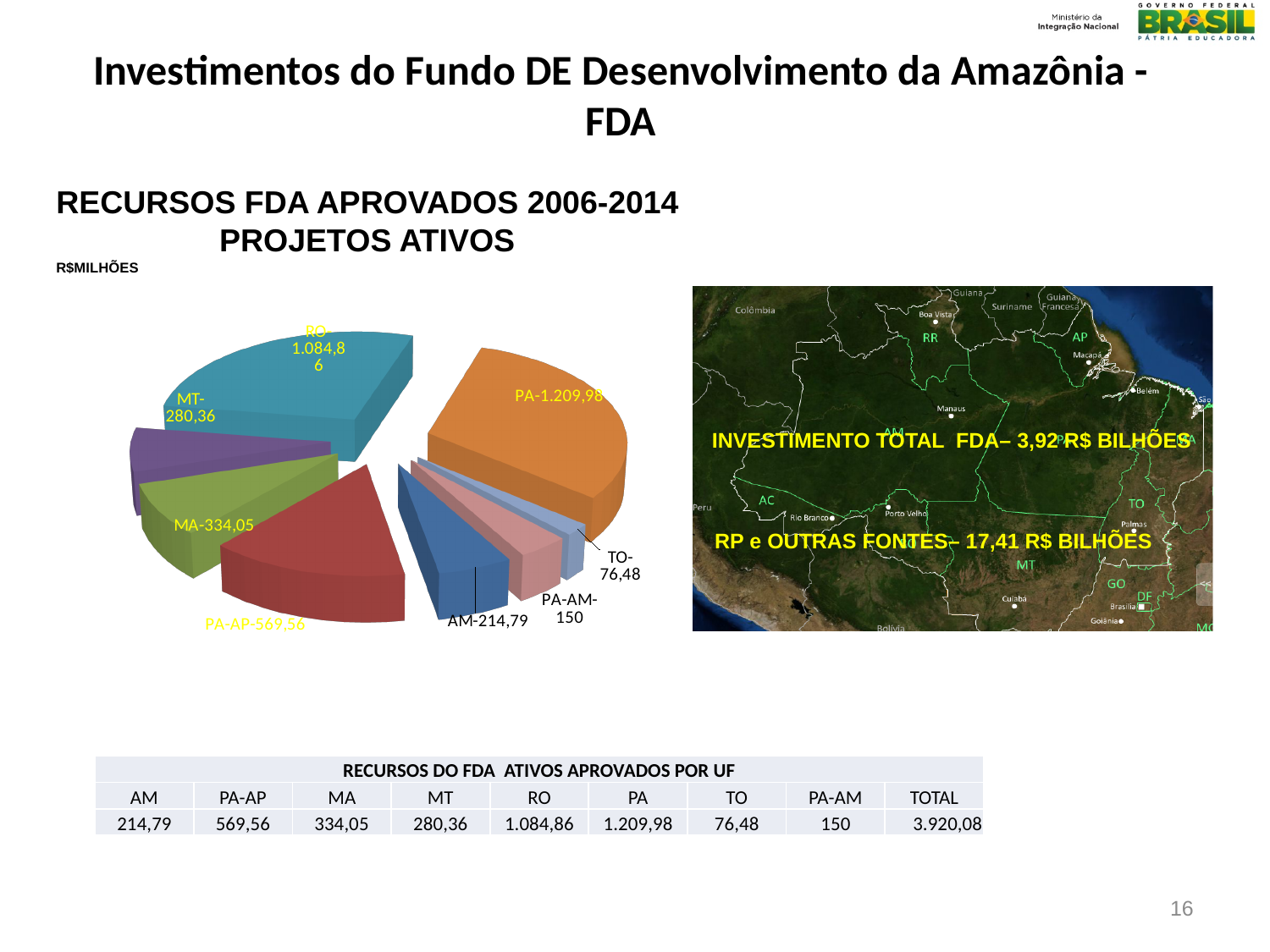
What is the difference between the values for PA and RO? 125,12 Which category has the largest slice in the pie chart? PA What is the difference between the values for MA and MT? 53,69 Which category has the smallest slice in the pie chart? TO How many slices does the pie chart have? 8 What is the value for RO in the pie chart? 1.084,86 What is the value for TO in the pie chart? 76,48 Which is larger, the value for PA-AP or the value for MA? PA-AP What is the value for PA in the pie chart? 1.209,98 In what unit are the values of the pie chart expressed? R$MILHÕES What kind of chart is shown on the slide? pie chart What is the value for PA-AM in the pie chart? 150